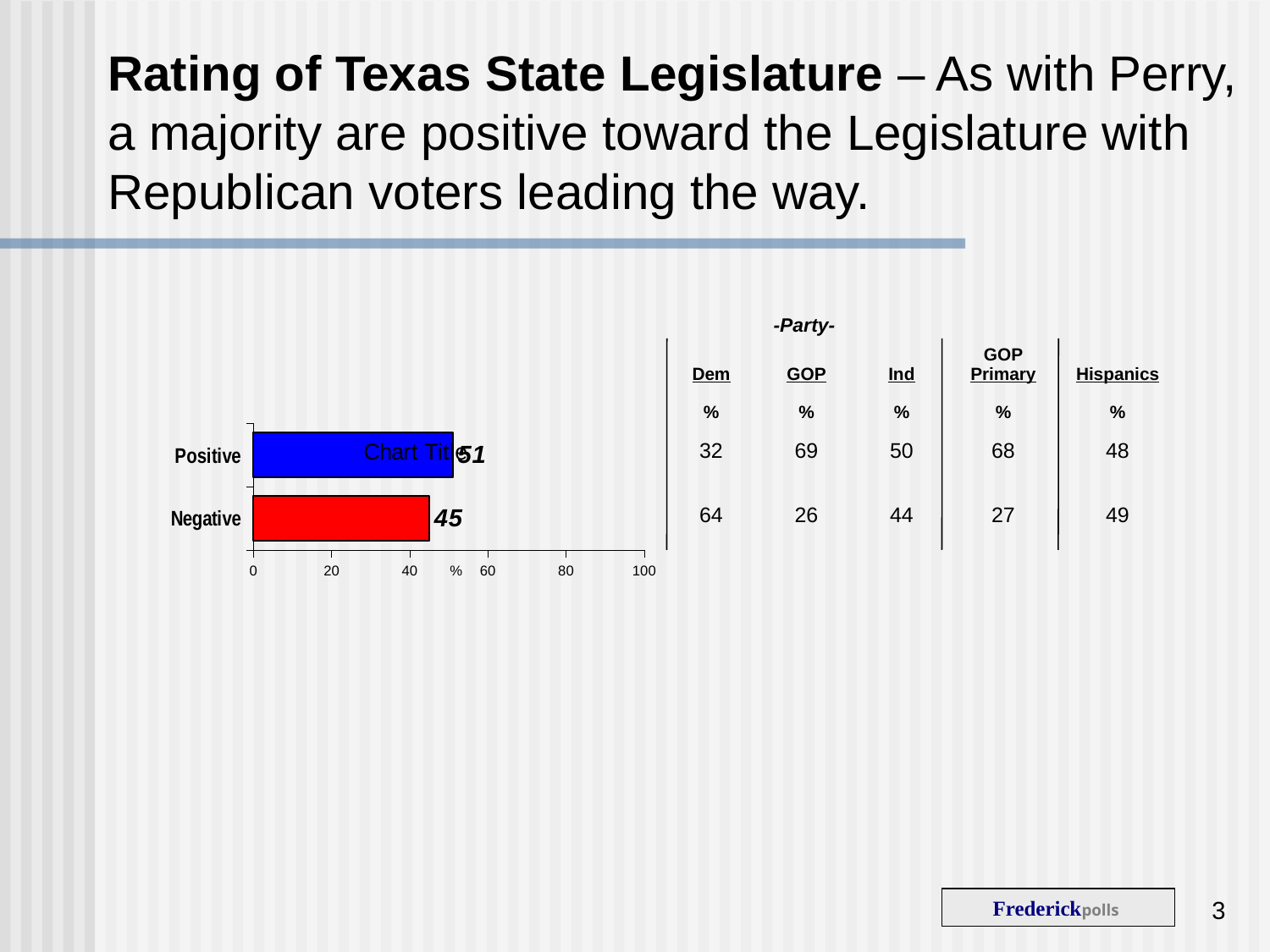
What value is shown for Positive in the bar chart? 51 What type of chart is shown on the slide? bar chart Which category in the bar chart has the lower value? Negative Is the value for Negative greater or less than 60? less What is the difference between the Positive and Negative values in the bar chart? 6 Which category in the bar chart has the higher value? Positive How many categories are plotted in the bar chart? 2 What is the maximum value shown on the chart's horizontal axis? 100 Is the value for Positive larger or smaller than the value for Negative? larger Is the value for Positive greater or less than 40? greater What value is shown for Negative in the bar chart? 45 What colour is the Positive bar in the chart? blue